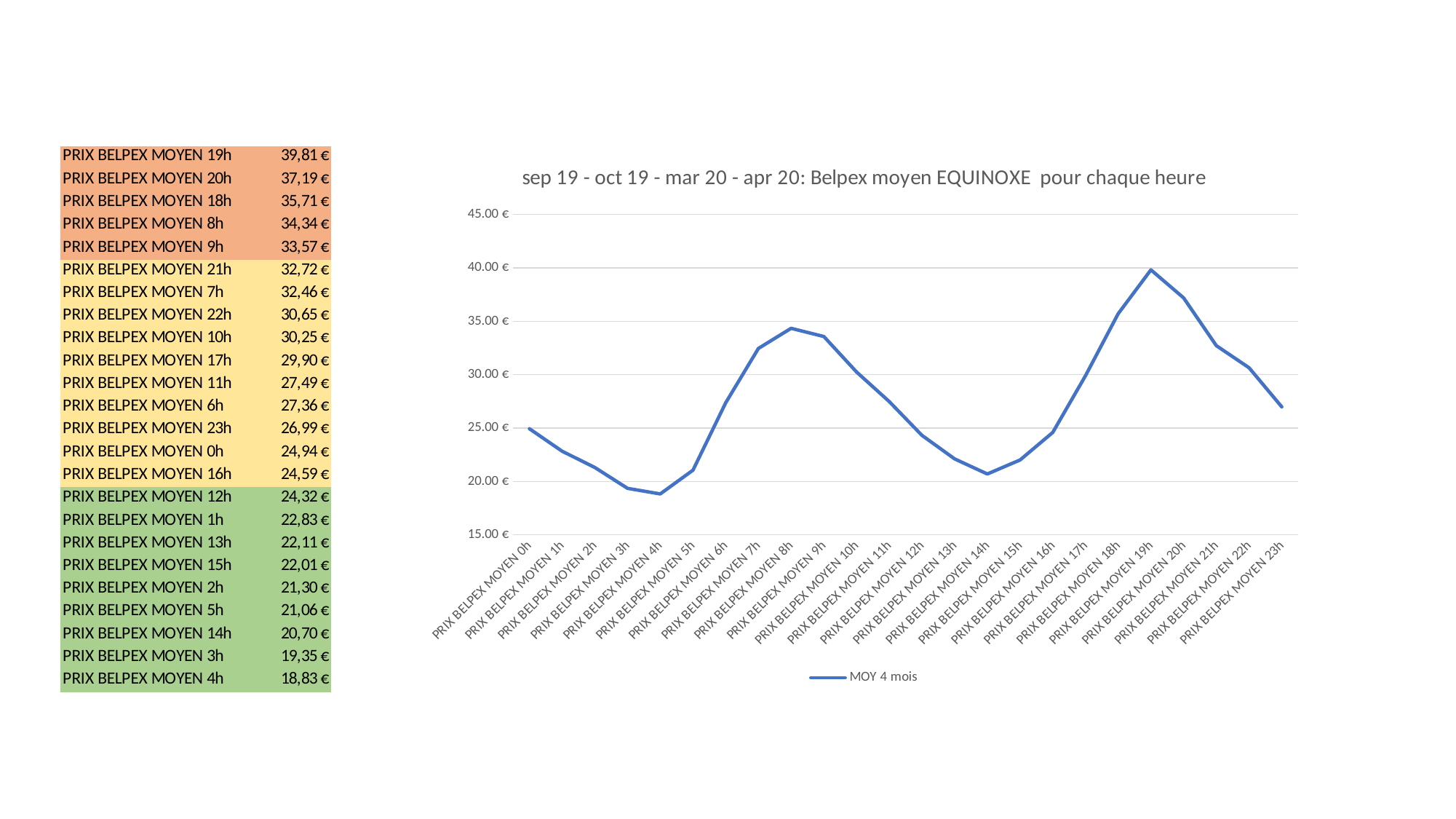
Which hour has the lowest value on the chart? PRIX BELPEX MOYEN 4h Which is larger, the value for PRIX BELPEX MOYEN 8h or PRIX BELPEX MOYEN 20h? PRIX BELPEX MOYEN 20h Do the values rise or fall from PRIX BELPEX MOYEN 14h to PRIX BELPEX MOYEN 19h? rise Is the value for PRIX BELPEX MOYEN 8h greater or less than 30.00 €? greater According to the table on the slide, what is the value for PRIX BELPEX MOYEN 19h? 39,81 € What is the name of the series shown in the chart legend? MOY 4 mois How many series does the chart legend list? 1 Is the value for PRIX BELPEX MOYEN 14h greater or less than 25.00 €? less Is the value for PRIX BELPEX MOYEN 4h greater or less than 20.00 €? less How many hourly points are plotted on the chart? 24 What kind of chart is shown on the slide? line chart Which hour has the highest value on the chart? PRIX BELPEX MOYEN 19h